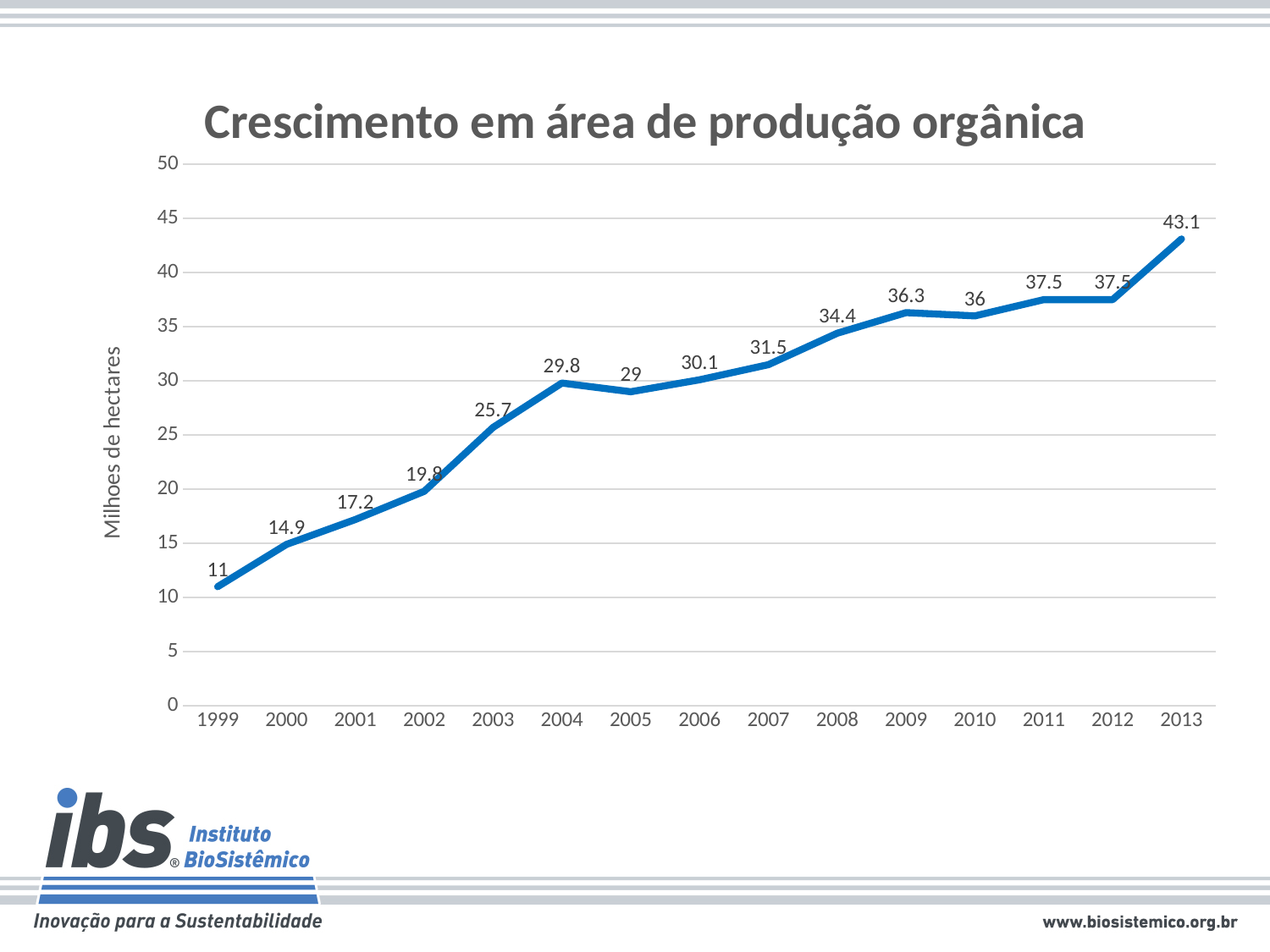
What is the value for 1999? 11 Which is larger, the value for 2009 or the value for 2010? 2009 What is the title of the chart? Crescimento em área de produção orgânica How many years are plotted on the x axis? 15 Do the values generally rise or fall from 1999 to 2013? Rise Is the value for 2003 greater or less than 25? greater What is the difference between the values for 2013 and 2012? 5.6 What is the value for 2004? 29.8 Which year has the lowest value? 1999 What is the value for 2008? 34.4 Which year has the highest value? 2013 What kind of chart is shown? Line chart